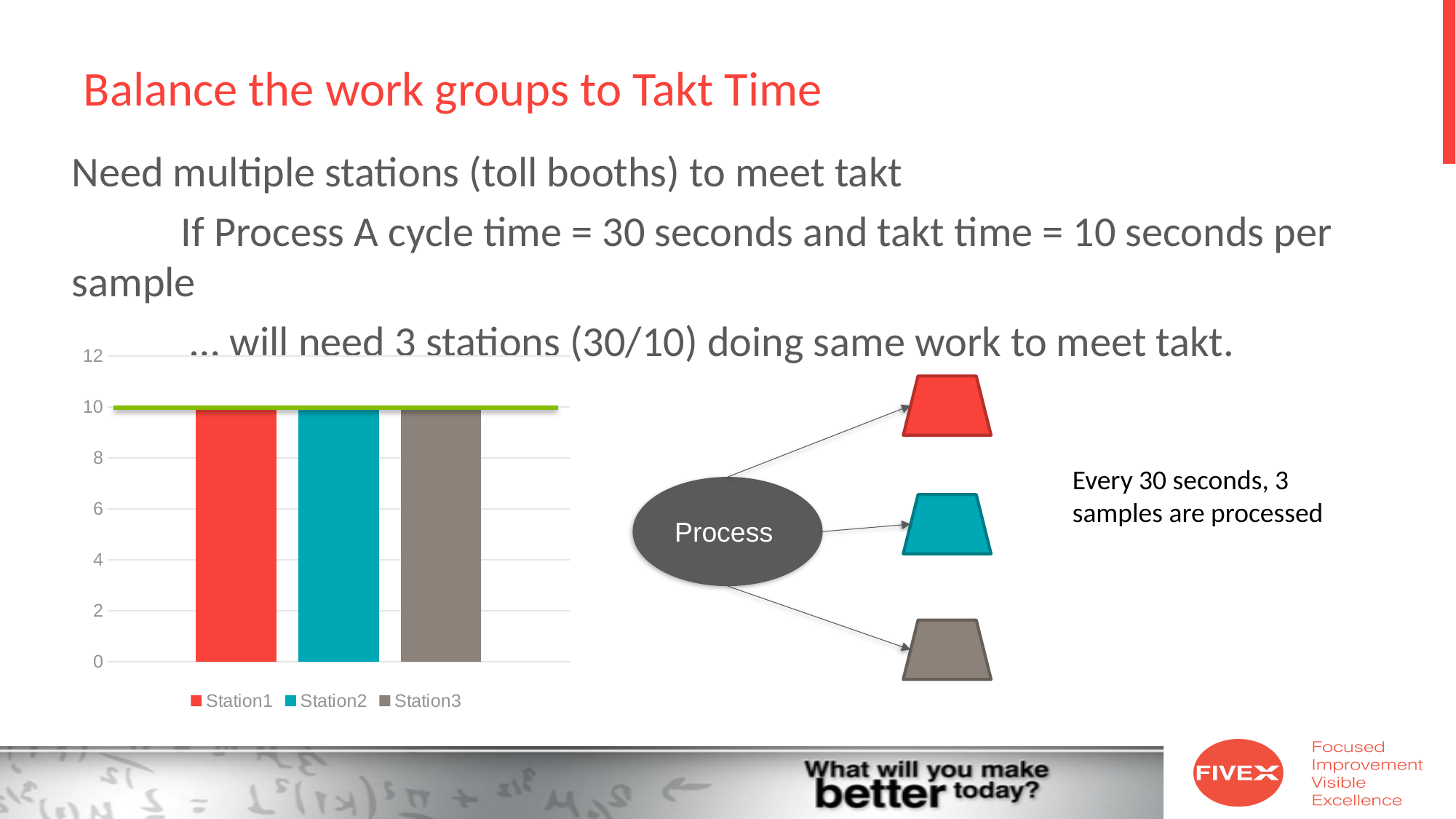
What value does the Station1 bar reach on the y axis? 10 What colour is the Station2 bar in the chart? teal How many series does the chart legend list? 3 Is the value for Station1 greater or less than 8? greater Is the value for Station3 greater or less than 12? less How many bars are plotted in the chart? 3 Do the bar values rise, fall, or stay the same from Station1 to Station3? stay the same What kind of chart is shown on the slide? bar chart What value does the Station3 bar reach on the y axis? 10 What is the highest value shown on the chart's y axis? 12 What value does the Station2 bar reach on the y axis? 10